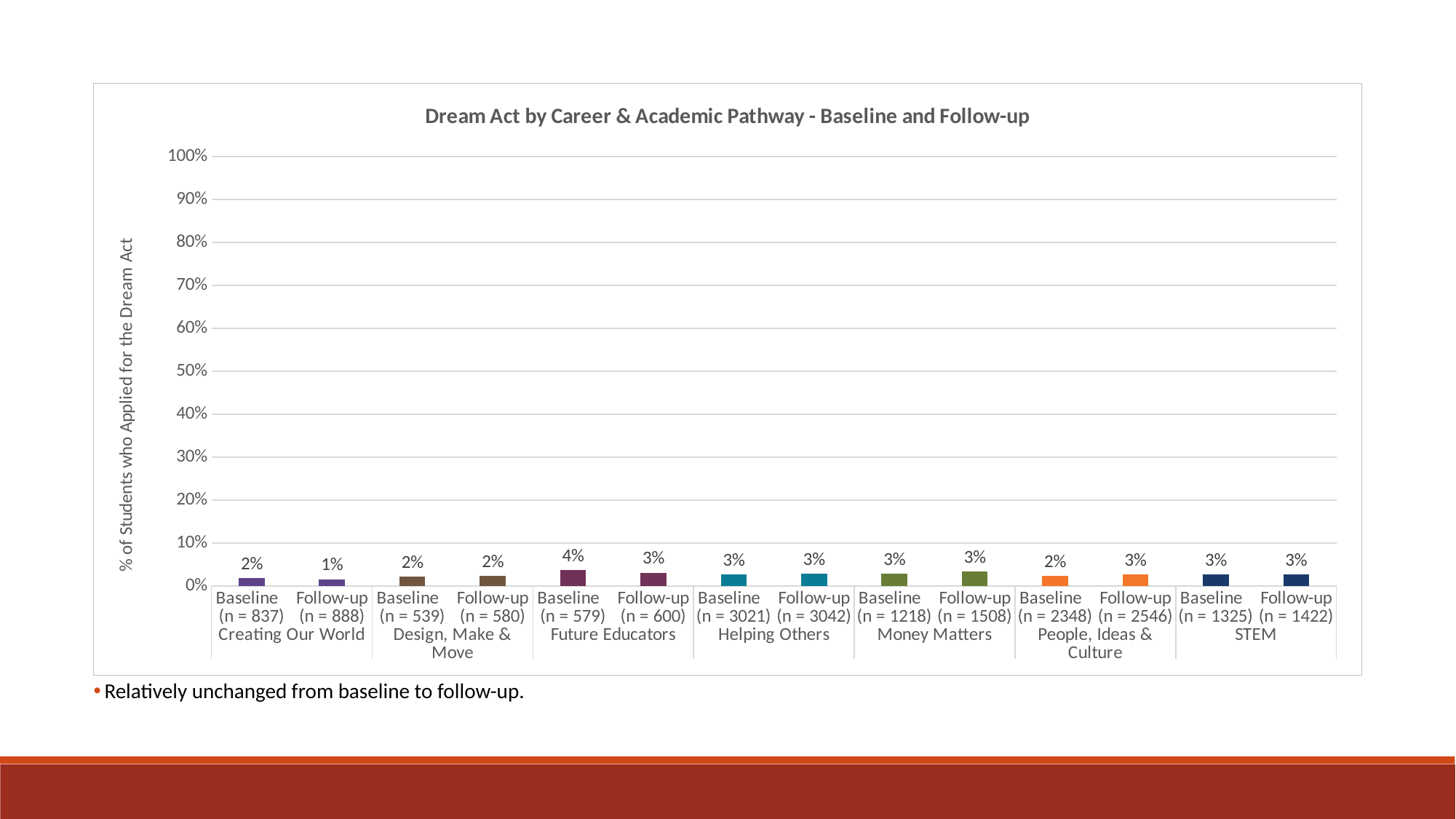
Is the Baseline value for Helping Others greater or less than 10%? less What is the Baseline value for STEM? 3% What is the Follow-up value for Creating Our World? 1% What is the title of the chart? Dream Act by Career & Academic Pathway - Baseline and Follow-up Which is larger for People, Ideas & Culture: the Baseline value or the Follow-up value? Follow-up What is the Follow-up value for People, Ideas & Culture? 3% How many career and academic pathways are shown on the x axis? 7 What kind of chart is shown on the slide? bar chart Which bar has the highest value on the chart? Future Educators Baseline What is the Baseline value for Future Educators? 4% What is the difference between the Baseline and Follow-up values for Future Educators? 1% Which bar has the lowest value on the chart? Creating Our World Follow-up